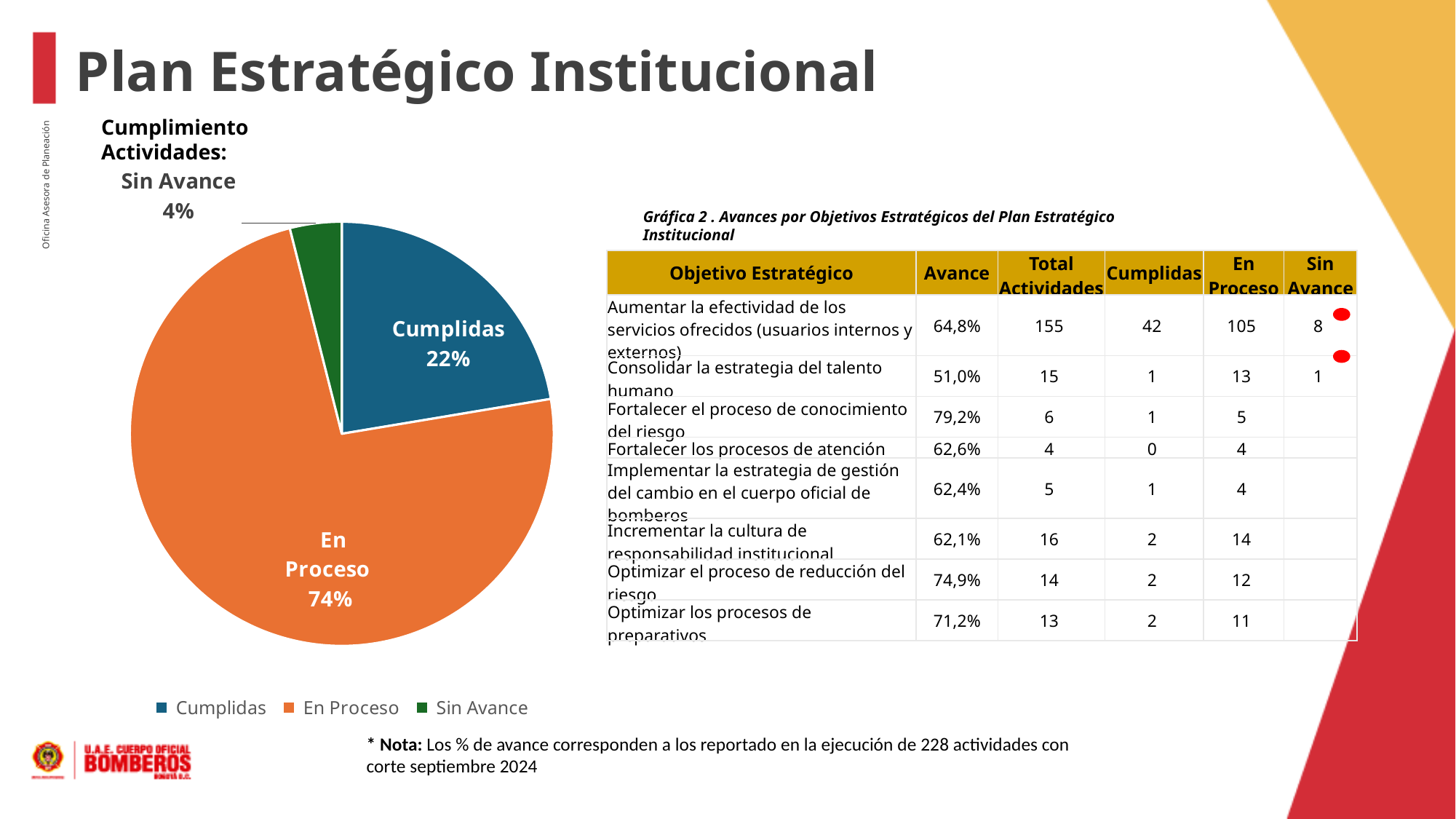
Which category has the largest slice in the pie chart? En Proceso How many entries does the pie chart legend list? 3 What is the share of the 'Cumplidas' slice in the pie chart? 22% Which slice is larger in the pie chart, 'Cumplidas' or 'Sin Avance'? Cumplidas What is the title of the pie chart? Cumplimiento Actividades: What is the difference in percentage points between the 'En Proceso' and 'Cumplidas' slices? 52 What colour is the 'En Proceso' slice in the pie chart? orange How many slices does the pie chart have? 3 Which category has the smallest slice in the pie chart? Sin Avance What kind of chart is shown on the slide? pie chart What is the share of the 'En Proceso' slice in the pie chart? 74% What is the share of the 'Sin Avance' slice in the pie chart? 4%